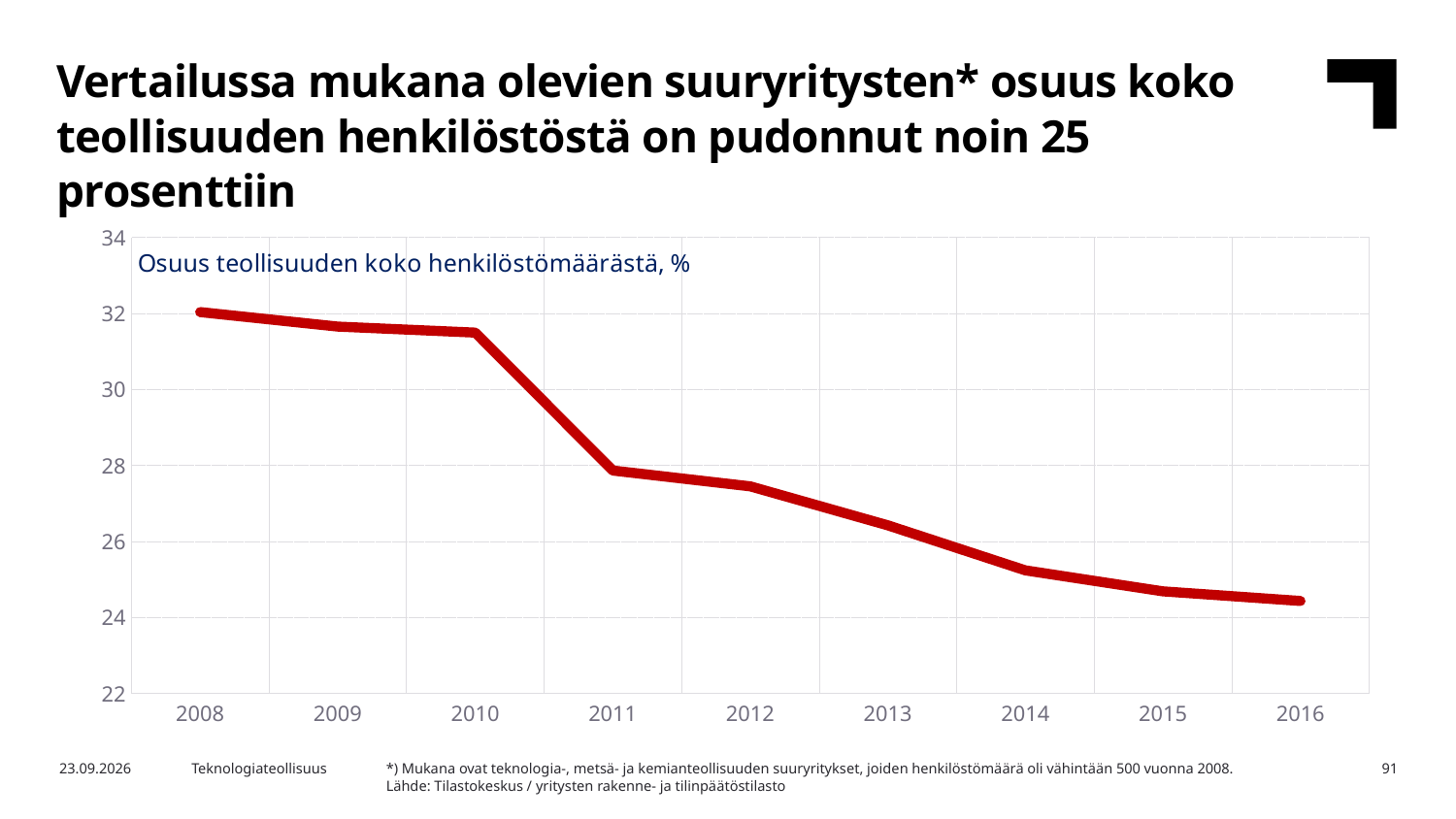
Is the value for 2008 greater or less than 30? greater Which year has the larger value, 2010 or 2011? 2010 Is the value for 2014 greater or less than 26? less Which year has the larger value, 2013 or 2015? 2013 Do the values in the chart rise or fall from 2008 to 2016? fall Which year has the highest value in the chart? 2008 How many years are plotted on the x axis of the chart? 9 Which year has the lowest value in the chart? 2016 What is the title shown inside the chart area? Osuus teollisuuden koko henkilöstömäärästä, % Is the value for 2016 greater or less than 24? greater What kind of chart is shown on the slide? line chart